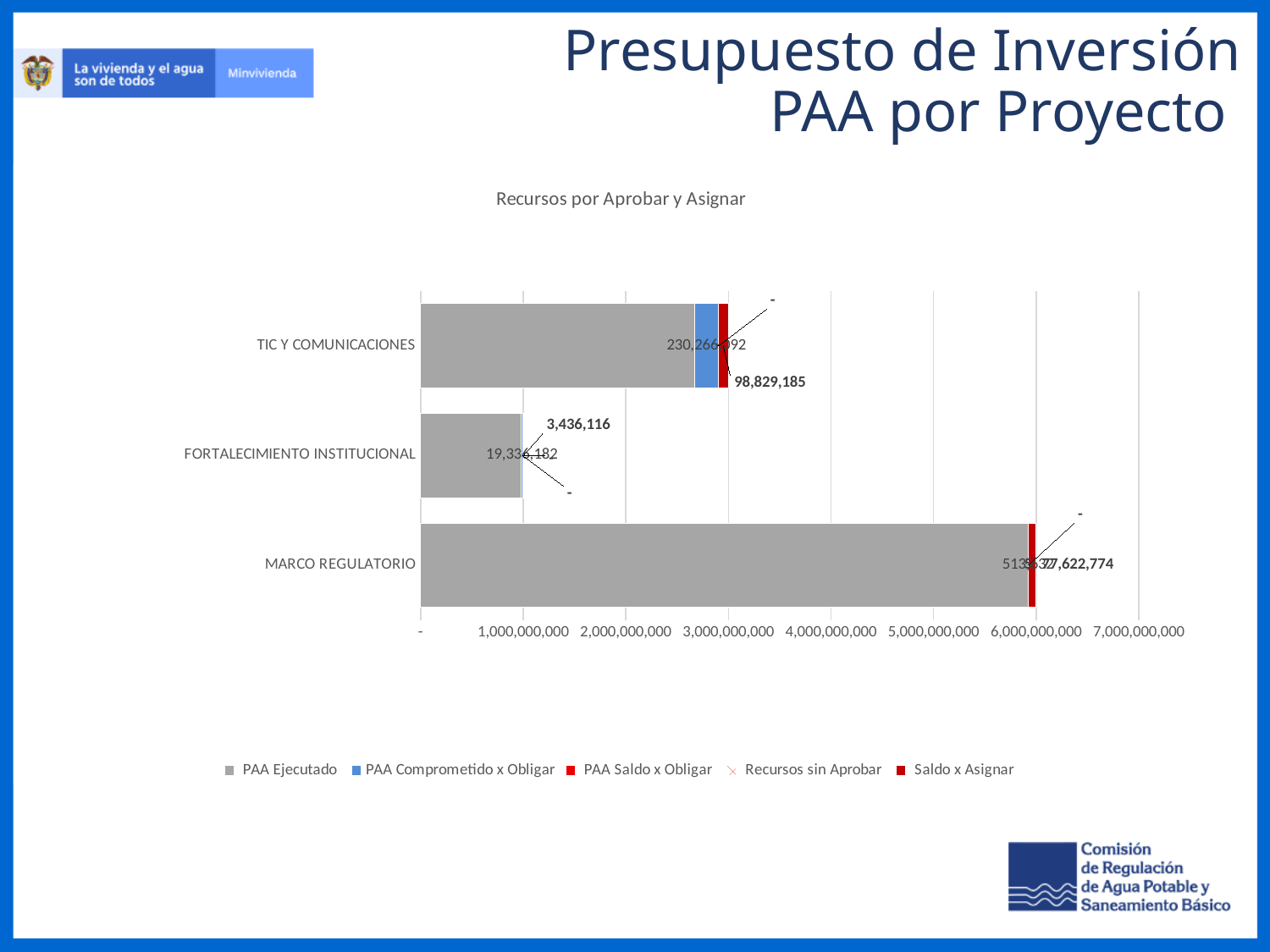
What is the title of the chart? Recursos por Aprobar y Asignar Which category has the shortest bar overall? FORTALECIMIENTO INSTITUCIONAL Which has a larger PAA Ejecutado bar, TIC Y COMUNICACIONES or FORTALECIMIENTO INSTITUCIONAL? TIC Y COMUNICACIONES How many categories (projects) are shown on the chart? 3 What is the highest value shown on the horizontal axis? 7,000,000,000 Is the PAA Ejecutado value for MARCO REGULATORIO greater or less than 5,000,000,000? greater Which category has the longest bar overall? MARCO REGULATORIO What bold data label is shown next to the FORTALECIMIENTO INSTITUCIONAL bar? 3,436,116 How many series does the legend list? 5 What kind of chart is shown on the slide? bar chart Is the PAA Ejecutado value for TIC Y COMUNICACIONES greater or less than 3,000,000,000? less